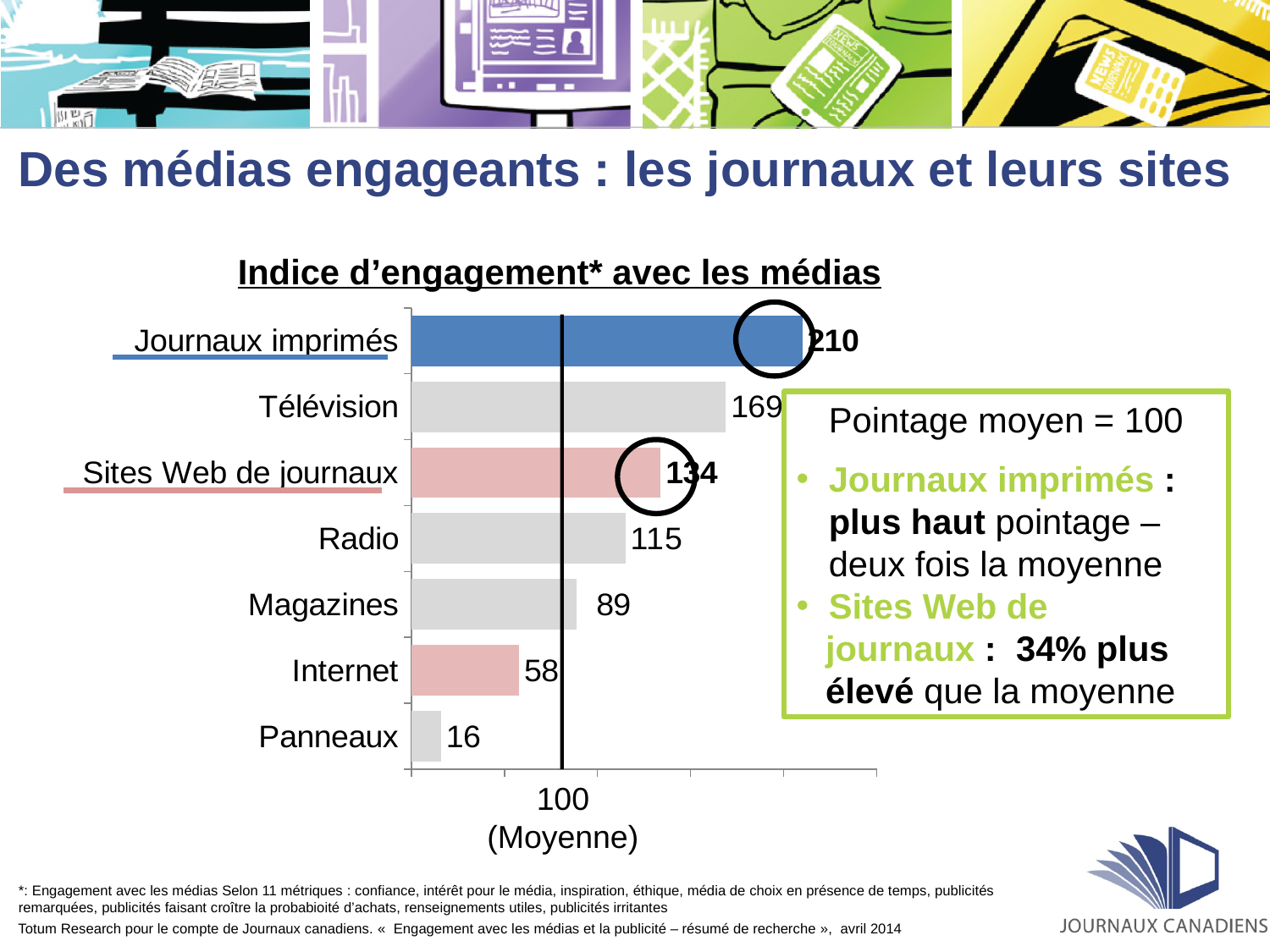
Which medium has the lowest engagement index? Panneaux What is the engagement index value for Télévision? 169 How many media categories are shown in the chart? 7 What value does the vertical reference line in the chart mark? 100 (Moyenne) What is the engagement index value for Sites Web de journaux? 134 What is the difference between the engagement index of Journaux imprimés and Télévision? 41 What is the engagement index value for Journaux imprimés? 210 What is the engagement index value for Panneaux? 16 Which has a higher engagement index, Internet or Magazines? Magazines What is the difference between the engagement index of Radio and Magazines? 26 What type of chart is used to show the engagement index? Bar chart Which medium has the highest engagement index? Journaux imprimés